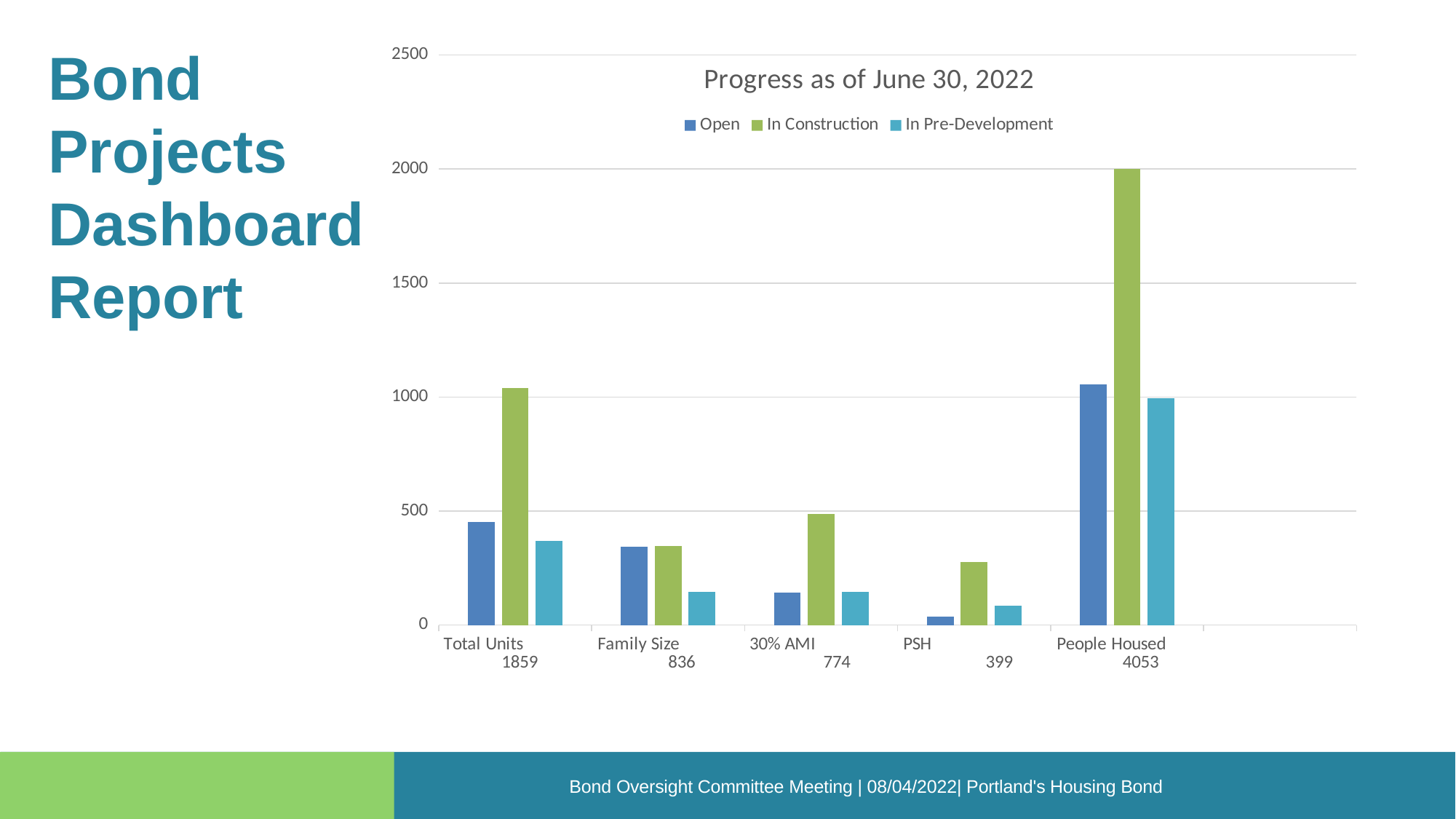
Which category has the shortest Open bar? PSH Is the Open value for Total Units greater or less than 500? less What kind of chart is shown on the slide? bar chart How many series does the chart legend list? 3 What number is printed beneath the People Housed category label? 4053 For Total Units, which is larger: the Open bar or the In Construction bar? In Construction What number is printed beneath the Total Units category label? 1859 What number is printed beneath the PSH category label? 399 Which category has the tallest In Construction bar? People Housed Is the Open value for People Housed greater or less than 1000? greater How many categories are shown on the x axis of the chart? 5 What is the title of the chart? Progress as of June 30, 2022